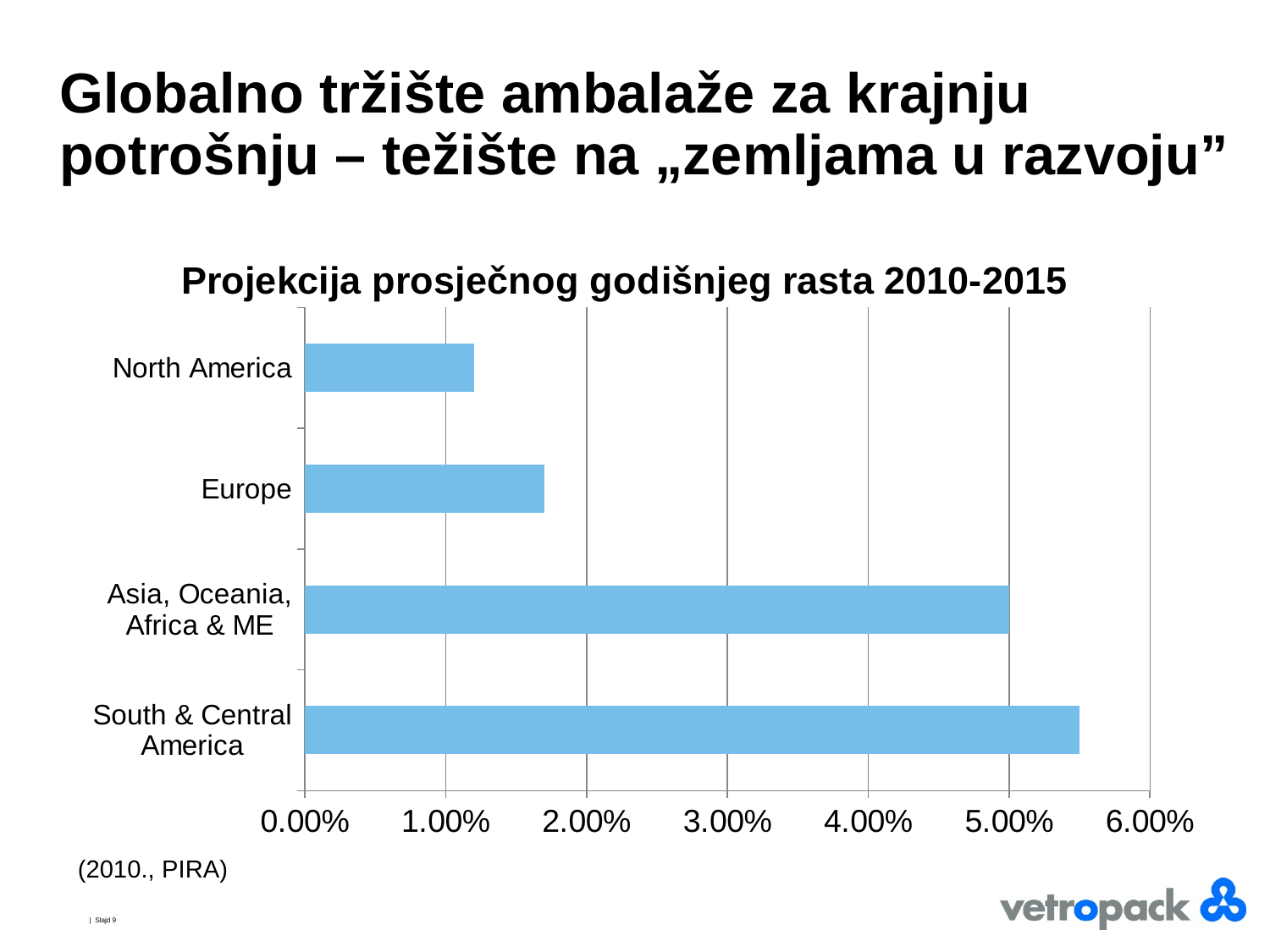
Is the value for North America greater or less than 2.00%? less Is the value for North America greater or less than 1.00%? greater What is the projected average annual growth for Asia, Oceania, Africa & ME? 5.00% Is the value for Europe greater or less than 2.00%? less Which region has the highest projected average annual growth? South & Central America What is the title of the chart? Projekcija prosječnog godišnjeg rasta 2010-2015 How many regions are shown in the chart? 4 Which region has the lowest projected average annual growth? North America Which has a higher projected growth, Europe or North America? Europe What kind of chart is shown on the slide? bar chart What source is cited below the chart? (2010., PIRA)